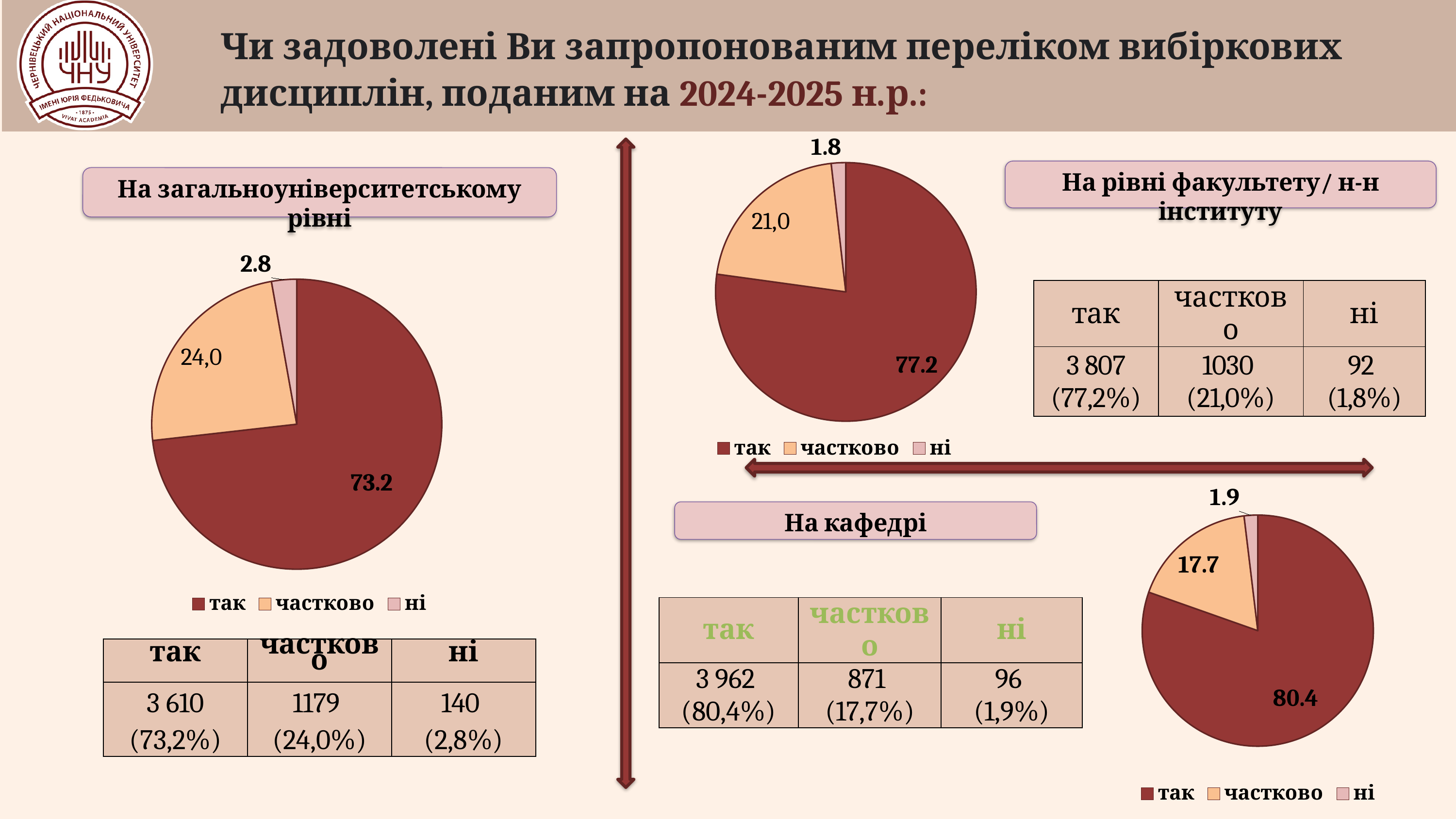
On the pie chart titled 'На кафедрі', what value is shown for the 'так' slice? 80.4 On the pie chart titled 'На рівні факультету/ н-н інституту', what value is shown for the 'так' slice? 77.2 On the pie chart titled 'На рівні факультету/ н-н інституту', what value is shown for the 'ні' slice? 1.8 How many entries does the legend of the 'На загальноуніверситетському рівні' chart list? 3 On the pie chart titled 'На рівні факультету/ н-н інституту', which slice is the smallest? ні On the pie chart titled 'На кафедрі', which slice is the largest? так On the pie chart titled 'На загальноуніверситетському рівні', what value is shown for the 'ні' slice? 2.8 On the pie chart titled 'На кафедрі', what value is shown for the 'частково' slice? 17.7 On the pie chart titled 'На загальноуніверситетському рівні', what value is shown for the 'так' slice? 73.2 On the pie chart titled 'На загальноуніверситетському рівні', what value is shown for the 'частково' slice? 24,0 On the pie chart titled 'На загальноуніверситетському рівні', what is the difference between the 'так' and 'частково' values? 49.2 What type of chart is used for 'На кафедрі'? pie chart